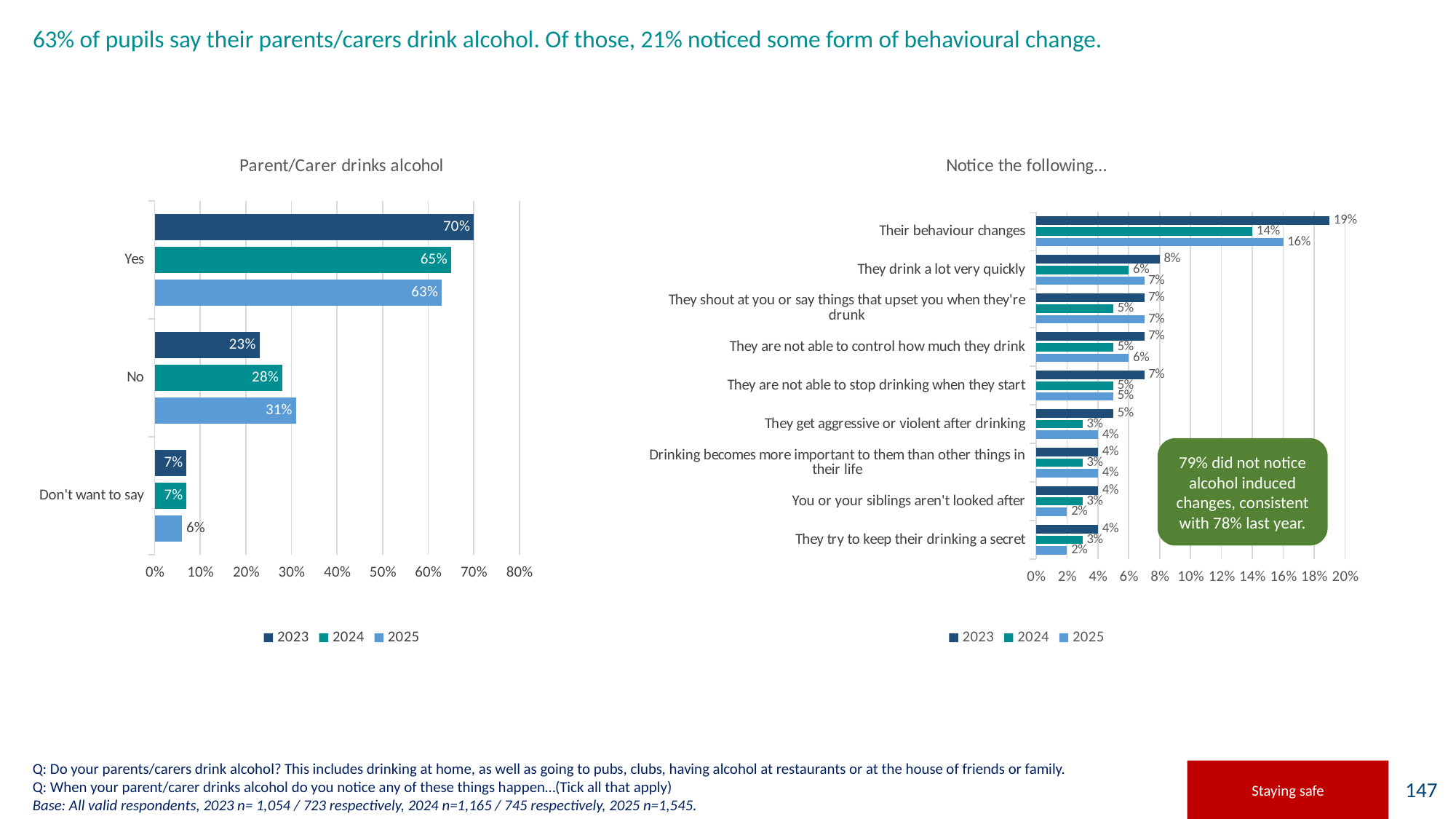
In the 'Notice the following...' chart, which is larger for 'They get aggressive or violent after drinking': the 2023 value or the 2024 value? 2023 In the 'Notice the following...' chart, which category has the highest 2024 value? Their behaviour changes In the 'Notice the following...' chart, what is the 2023 value for 'Their behaviour changes'? 19% In the 'Parent/Carer drinks alcohol' chart, what is the value for 'No' in 2023? 23% In the 'Parent/Carer drinks alcohol' chart, what is the value for 'Yes' in 2025? 63% In the 'Parent/Carer drinks alcohol' chart, how many response categories are shown? 3 In the 'Parent/Carer drinks alcohol' chart, what is the difference between the 2023 and 2025 values for 'Yes'? 7 percentage points In the 'Notice the following...' chart, what is the 2025 value for 'They drink a lot very quickly'? 7% What type of chart is the 'Parent/Carer drinks alcohol' chart? bar chart In the 'Parent/Carer drinks alcohol' chart, do the values for 'No' rise or fall from 2023 to 2025? rise In the 'Notice the following...' chart, how many categories are listed? 9 How many series does the legend of the 'Notice the following...' chart list? 3